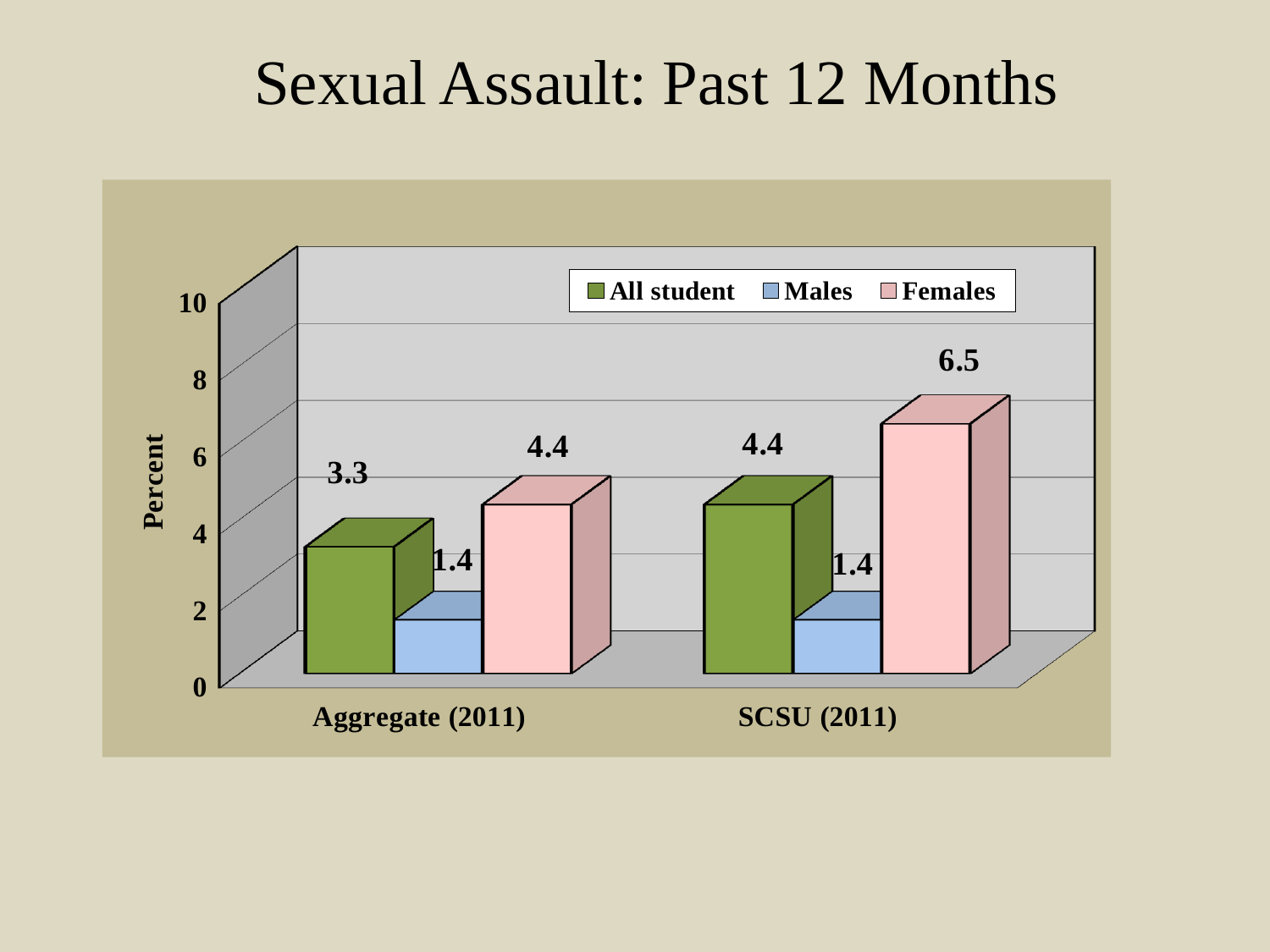
What is the difference between the Females values for SCSU (2011) and Aggregate (2011)? 2.1 What is the value for Females in the SCSU (2011) group? 6.5 Which series has the lowest value in the Aggregate (2011) group? Males Which is larger: the All student value for Aggregate (2011) or for SCSU (2011)? SCSU (2011) What is the value for All student in the Aggregate (2011) group? 3.3 How many series does the legend list? 3 What is the value for All student in the SCSU (2011) group? 4.4 What is the label of the vertical axis? Percent What is the value for Males in the Aggregate (2011) group? 1.4 Which series has the highest value in the SCSU (2011) group? Females How many category groups are shown on the x axis? 2 What kind of chart is shown on the slide? Bar chart